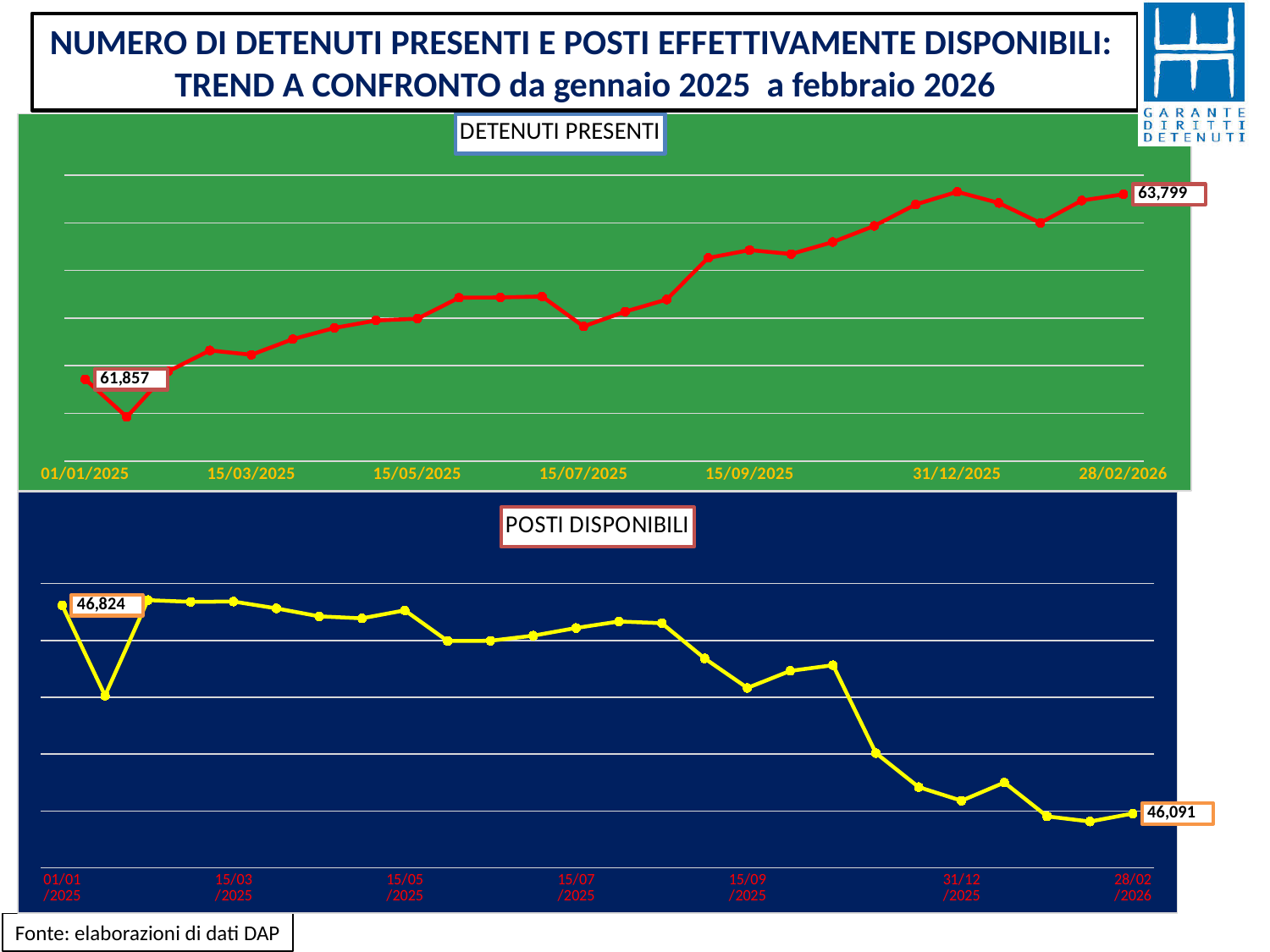
In the DETENUTI PRESENTI chart, what is the value labelled at 01/01/2025? 61,857 In the POSTI DISPONIBILI chart, what is the difference between the labelled value at 01/01/2025 and the labelled value at 28/02/2026? 733 In the DETENUTI PRESENTI chart, what is the value labelled at 28/02/2026? 63,799 What kind of chart is the DETENUTI PRESENTI chart? Line chart In the POSTI DISPONIBILI chart, what is the value labelled at 01/01/2025? 46,824 In the POSTI DISPONIBILI chart, what is the value labelled at 28/02/2026? 46,091 What colour is the line in the POSTI DISPONIBILI chart? Yellow In the POSTI DISPONIBILI chart, do the values generally rise or fall from 01/01/2025 to 28/02/2026? Fall In the DETENUTI PRESENTI chart, which labelled value is larger: 01/01/2025 or 28/02/2026? 28/02/2026 In the DETENUTI PRESENTI chart, do the values generally rise or fall from 01/01/2025 to 28/02/2026? Rise In the POSTI DISPONIBILI chart, which labelled value is larger: 01/01/2025 or 28/02/2026? 01/01/2025 In the DETENUTI PRESENTI chart, what is the difference between the labelled value at 28/02/2026 and the labelled value at 01/01/2025? 1,942